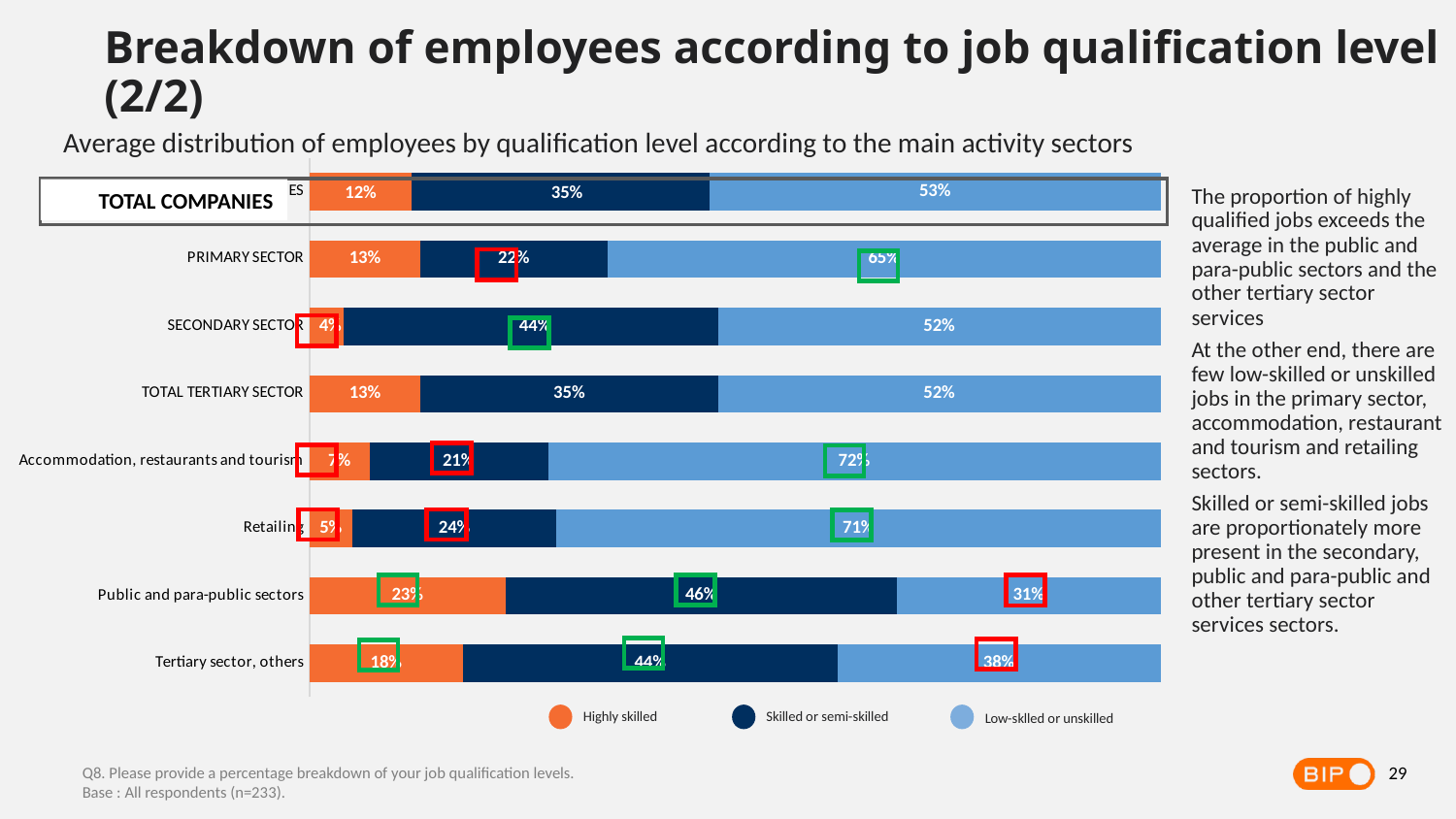
Which sector has the highest Low-skilled or unskilled share? Accommodation, restaurants and tourism How many series does the legend list? 3 What is the Skilled or semi-skilled share for the SECONDARY SECTOR? 44% What is the Low-skilled or unskilled share for the PRIMARY SECTOR? 65% Which sector has the lowest Highly skilled share? SECONDARY SECTOR Which colour represents the Highly skilled series in the chart? Orange How many sector categories are plotted in the chart? 8 What kind of chart is shown on the slide? Stacked bar chart What is the difference between the Low-skilled or unskilled share for Retailing and for Public and para-public sectors? 40% What is the Highly skilled share for TOTAL COMPANIES? 12% What is the Highly skilled share for Public and para-public sectors? 23% Which is larger: the Skilled or semi-skilled share for Public and para-public sectors or for Tertiary sector, others? Public and para-public sectors